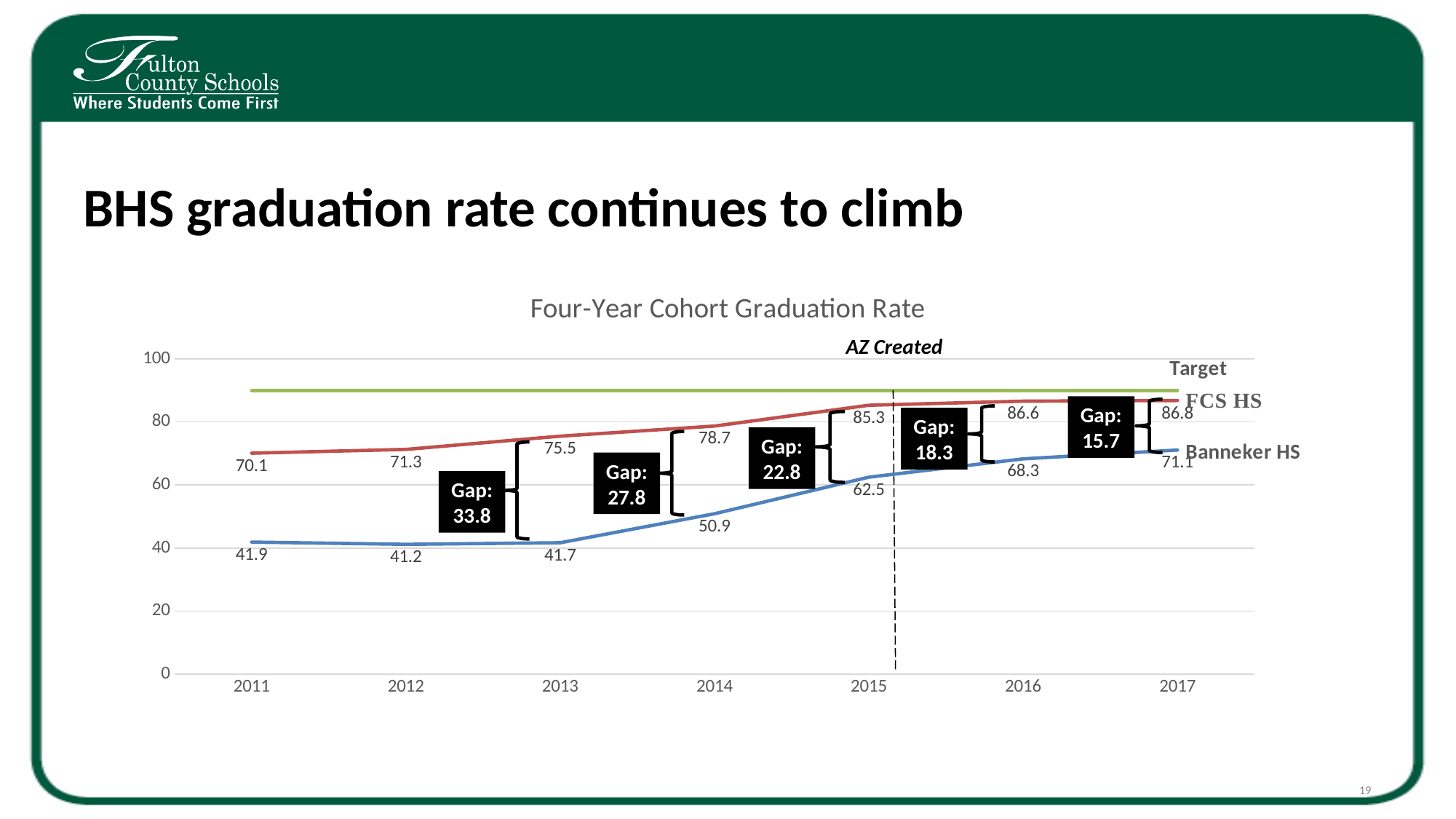
By how much did the Banneker HS graduation rate change from 2011 to 2017? 29.2 How many years are shown on the x axis? 7 Does the Banneker HS graduation rate rise or fall from 2013 to 2017? Rise What is the FCS HS graduation rate in 2015? 85.3 Is the Target line value greater or less than 80? greater In which year is the FCS HS graduation rate highest? 2017 What is the difference between the FCS HS and Banneker HS graduation rates in 2013? 33.8 In which year is the Banneker HS graduation rate lowest? 2012 Which is higher in 2016, the FCS HS rate or the Banneker HS rate? FCS HS What is the Banneker HS graduation rate in 2017? 71.1 What is the Banneker HS graduation rate in 2014? 50.9 What type of chart is shown? Line chart